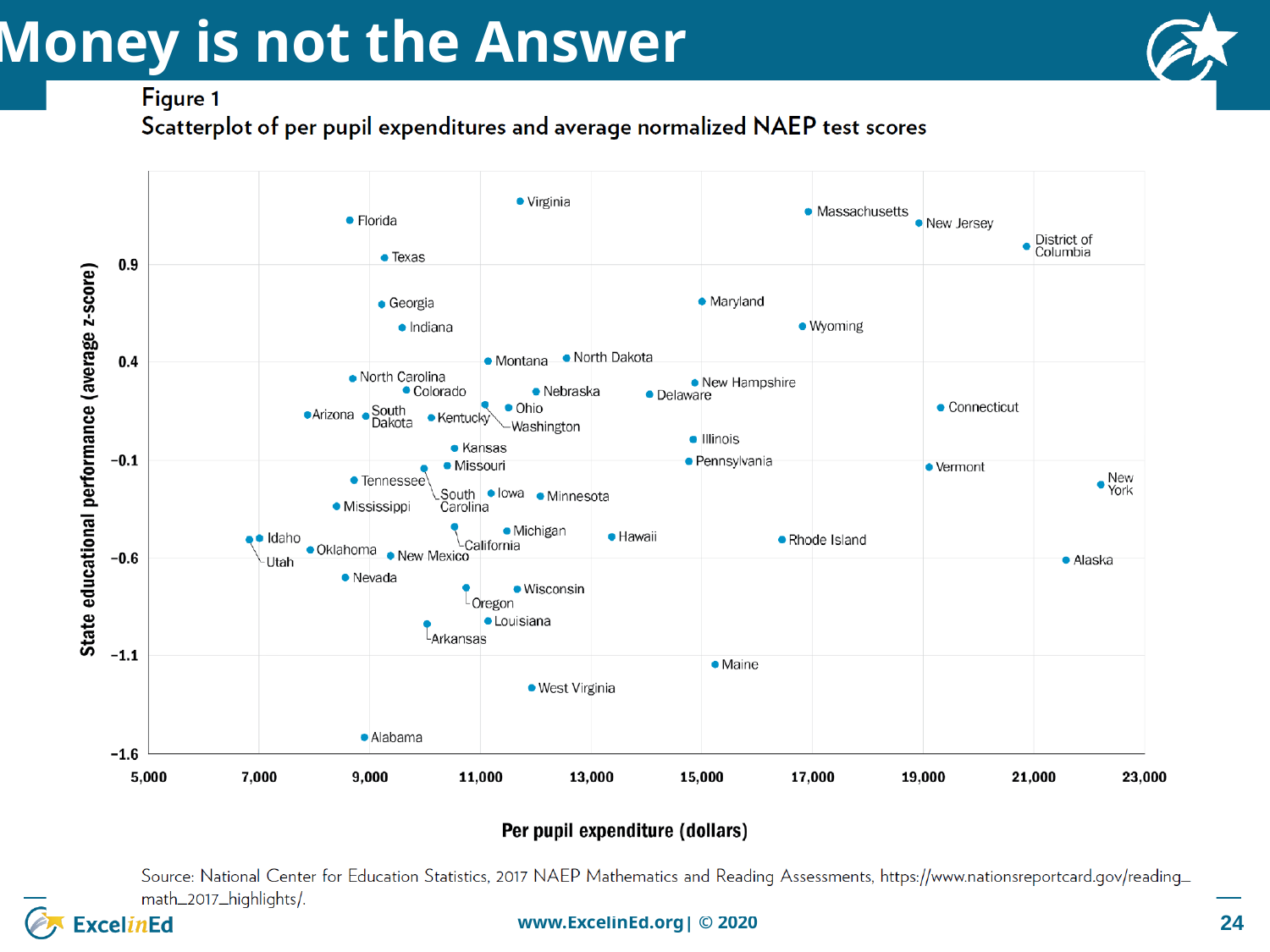
What is the label of the x axis of the scatterplot? Per pupil expenditure (dollars) Is the state educational performance value for Alabama greater or less than -1.1? less Which has the higher per pupil expenditure, Florida or New Jersey? New Jersey Which state has the highest per pupil expenditure in the scatterplot? New York Which has the higher state educational performance, Maryland or Wyoming? Maryland Is the per pupil expenditure for Massachusetts greater or less than 15,000? greater Is the state educational performance value for Virginia greater or less than 0.9? greater Which state has the lowest state educational performance (average z-score) in the scatterplot? Alabama What kind of chart is shown in Figure 1? scatter plot